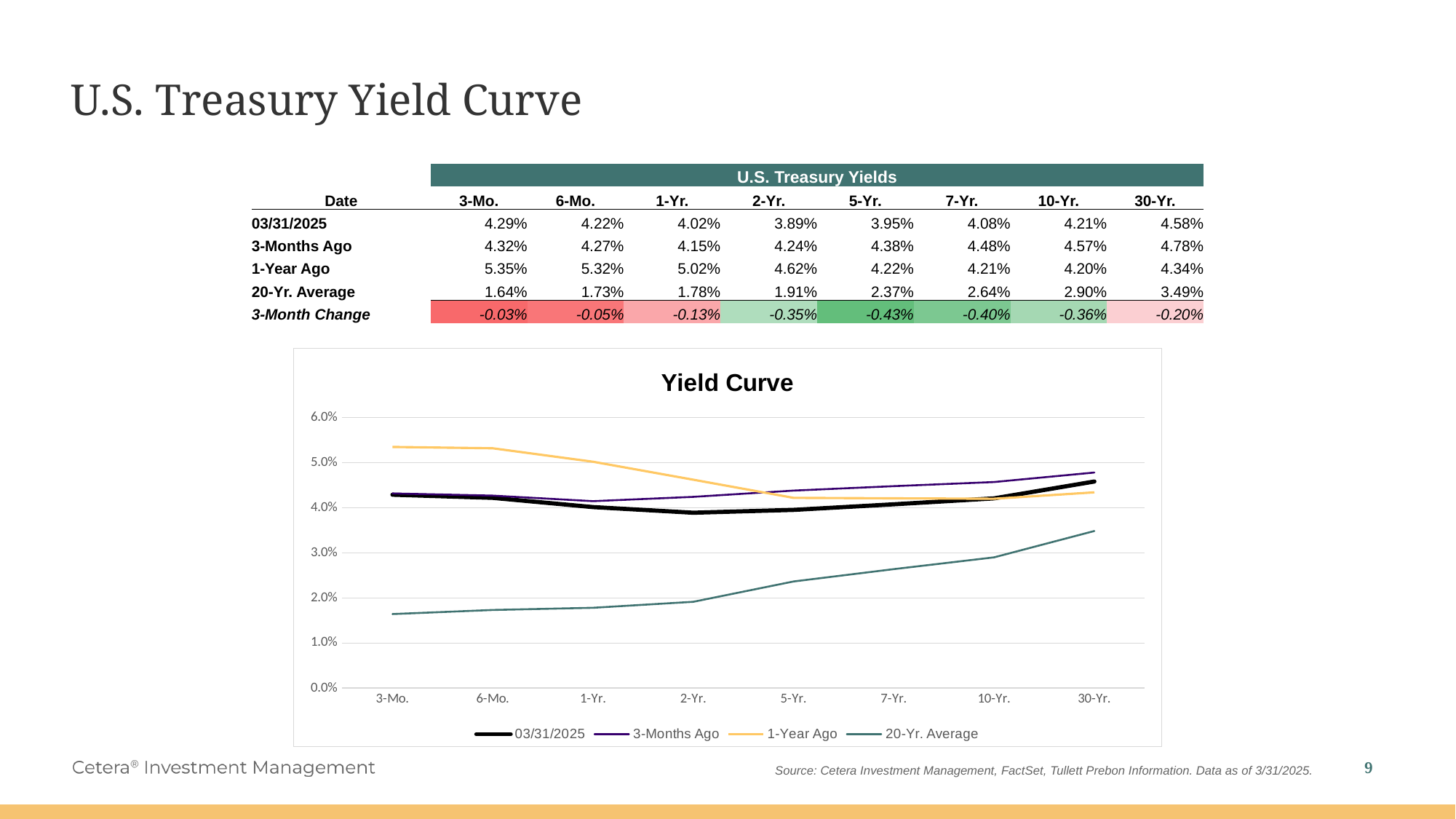
At which maturity is the 03/31/2025 yield lowest? 2-Yr. What is the difference between the 3-Months Ago yield and the 03/31/2025 yield at the 10-Yr. maturity? 0.36% How many series does the legend of the Yield Curve chart list? 4 At the 30-Yr. maturity, which is larger: the 03/31/2025 yield or the 1-Year Ago yield? 03/31/2025 What kind of chart is the "Yield Curve" chart? line chart What is the title of the line chart on the slide? Yield Curve In the Yield Curve chart, is the 20-Yr. Average value at 3-Mo. greater or less than 2.0%? less Does the 20-Yr. Average line rise or fall from 3-Mo. to 30-Yr. in the Yield Curve chart? rise How many maturities are plotted along the x axis of the Yield Curve chart? 8 What is the 20-Yr. Average yield at the 5-Yr. maturity? 2.37% Which series has the highest value at the 3-Mo. maturity in the Yield Curve chart? 1-Year Ago What is the 03/31/2025 yield for the 30-Yr. maturity? 4.58%